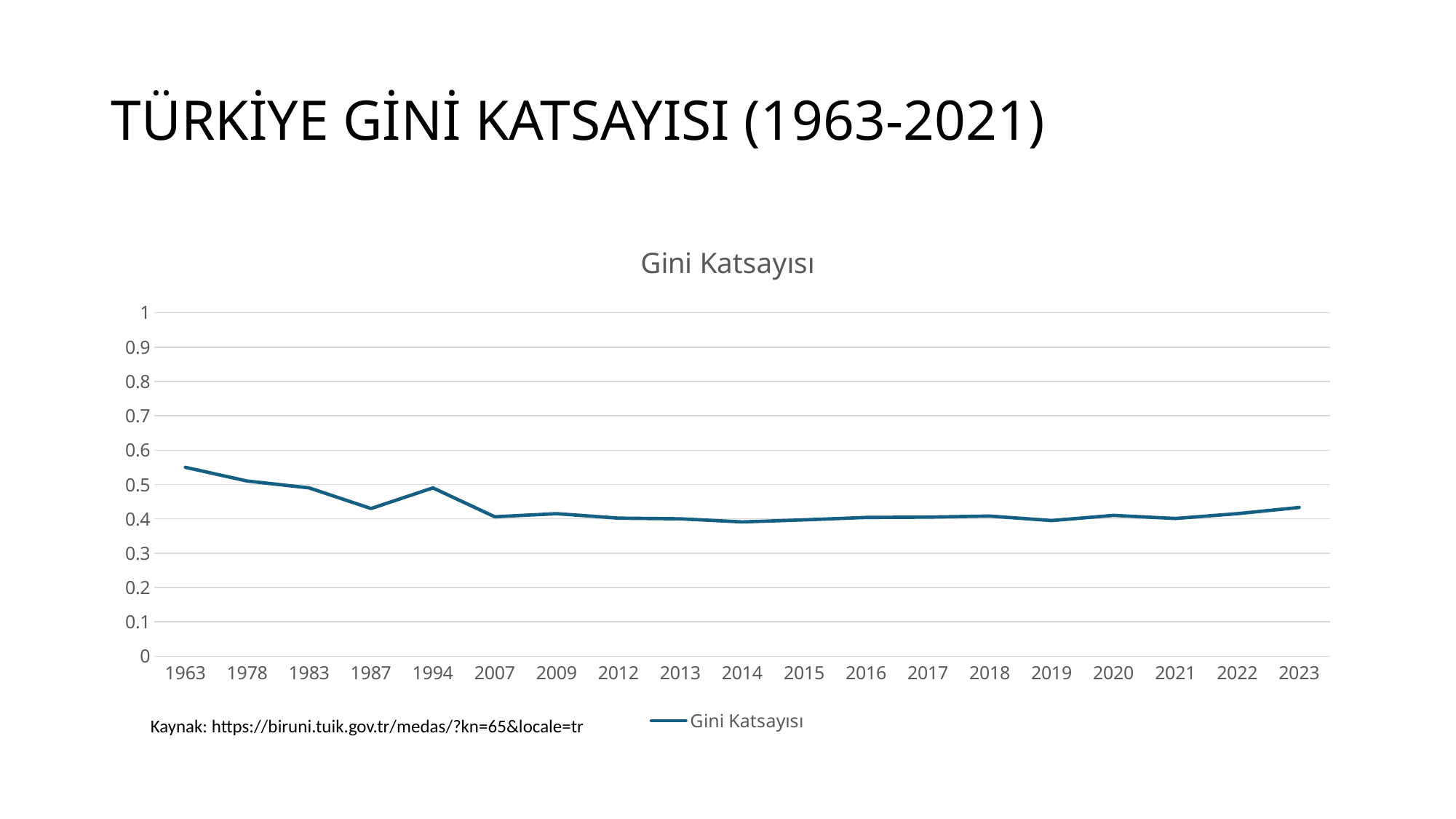
Does the Gini Katsayısı value rise or fall from 1963 to 1987? fall How many years are plotted along the x axis? 19 Which is larger, the value for 1963 or the value for 2023? 1963 Is the value for 2023 greater or less than 0.4? greater Is the value for 2012 greater or less than 0.5? less Which is larger, the value for 1994 or the value for 2007? 1994 Is the value for 1963 greater or less than 0.5? greater What kind of chart is shown on the slide? line chart Which year has the highest Gini Katsayısı value? 1963 How many series does the legend list? 1 What is the title of the chart? Gini Katsayısı